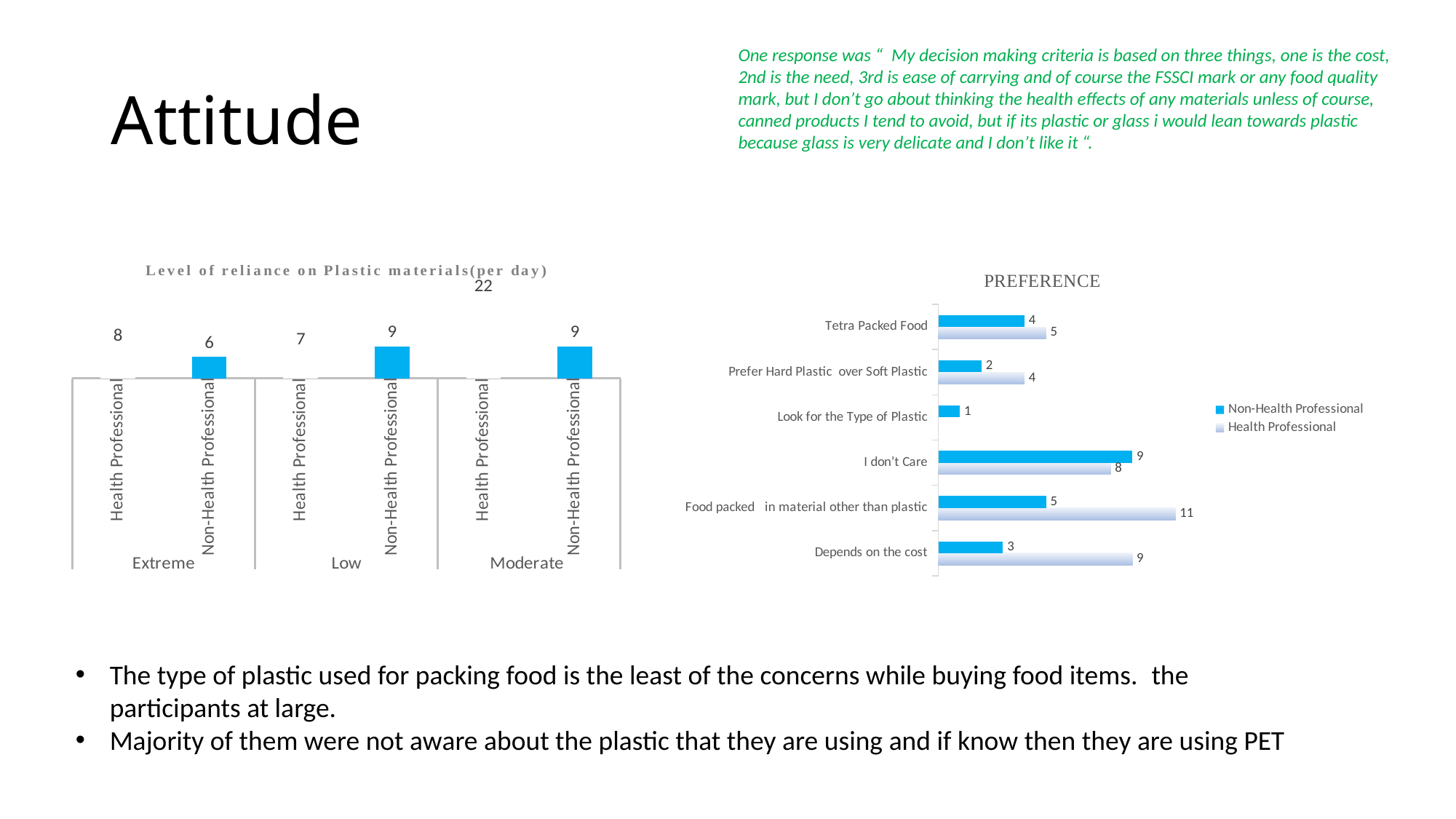
In the "Level of reliance on Plastic materials(per day)" chart, what are the three reliance levels shown on the x axis? Extreme, Low, Moderate How many categories are shown in the PREFERENCE chart? 6 In the PREFERENCE chart, what is the value for Health Professional for "Food packed in material other than plastic"? 11 What kind of chart is the PREFERENCE chart? Bar chart In the PREFERENCE chart, what is the value for Non-Health Professional for "Look for the Type of Plastic"? 1 In the "Level of reliance on Plastic materials(per day)" chart, what is the value for Non-Health Professional under Extreme? 6 In the "Level of reliance on Plastic materials(per day)" chart, what is the value for Non-Health Professional under Low? 9 In the PREFERENCE chart, for "Tetra Packed Food", which is larger: the Health Professional value or the Non-Health Professional value? Health Professional In the PREFERENCE chart, which category has the highest Health Professional value? Food packed in material other than plastic How many series does the legend of the PREFERENCE chart list? 2 In the PREFERENCE chart, what is the difference between the Health Professional and Non-Health Professional values for "Depends on the cost"? 6 In the PREFERENCE chart, what is the value for Non-Health Professional for "I don't Care"? 9